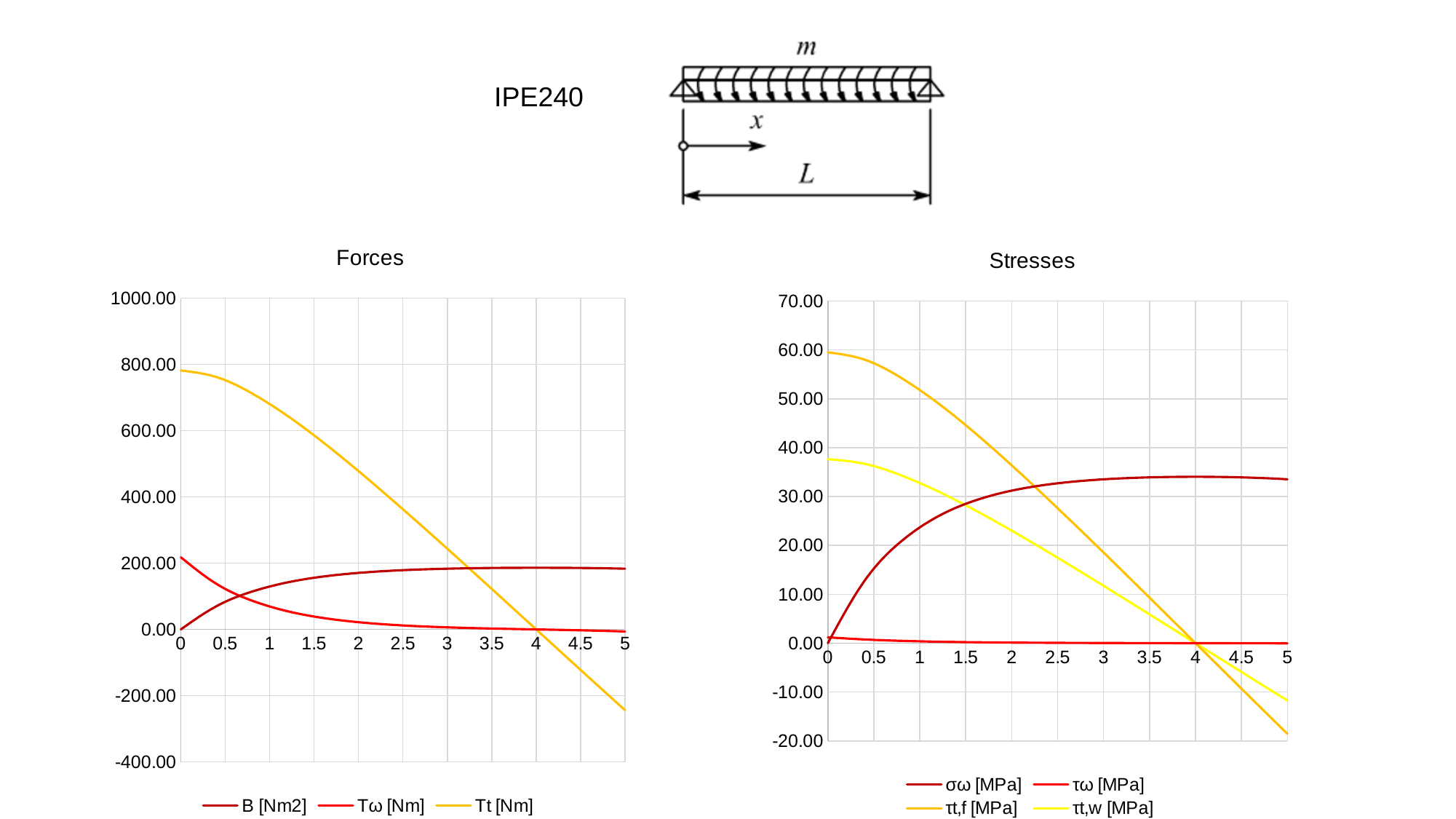
In the Forces chart, does the Tt [Nm] series rise or fall as x increases from 0 to 5? fall In the Stresses chart, is the value of τt,w [MPa] at x = 0 greater or less than 30.00? greater What kind of chart is the Forces chart? line chart In the Forces chart, does the B [Nm2] series rise or fall as x increases from 0 to 5? rise How many series does the legend of the Forces chart list? 3 In the Forces chart, is the value of Tt [Nm] at x = 0 greater or less than 600.00? greater In the Stresses chart, is the value of τt,f [MPa] at x = 0 greater or less than 50.00? greater How many series does the legend of the Stresses chart list? 4 What is the title of the chart on the right side of the slide? Stresses In the Forces chart, at x = 0, which series has the larger value: Tt [Nm] or Tω [Nm]? Tt [Nm] In the Stresses chart, does the τt,f [MPa] series rise or fall as x increases from 0 to 5? fall